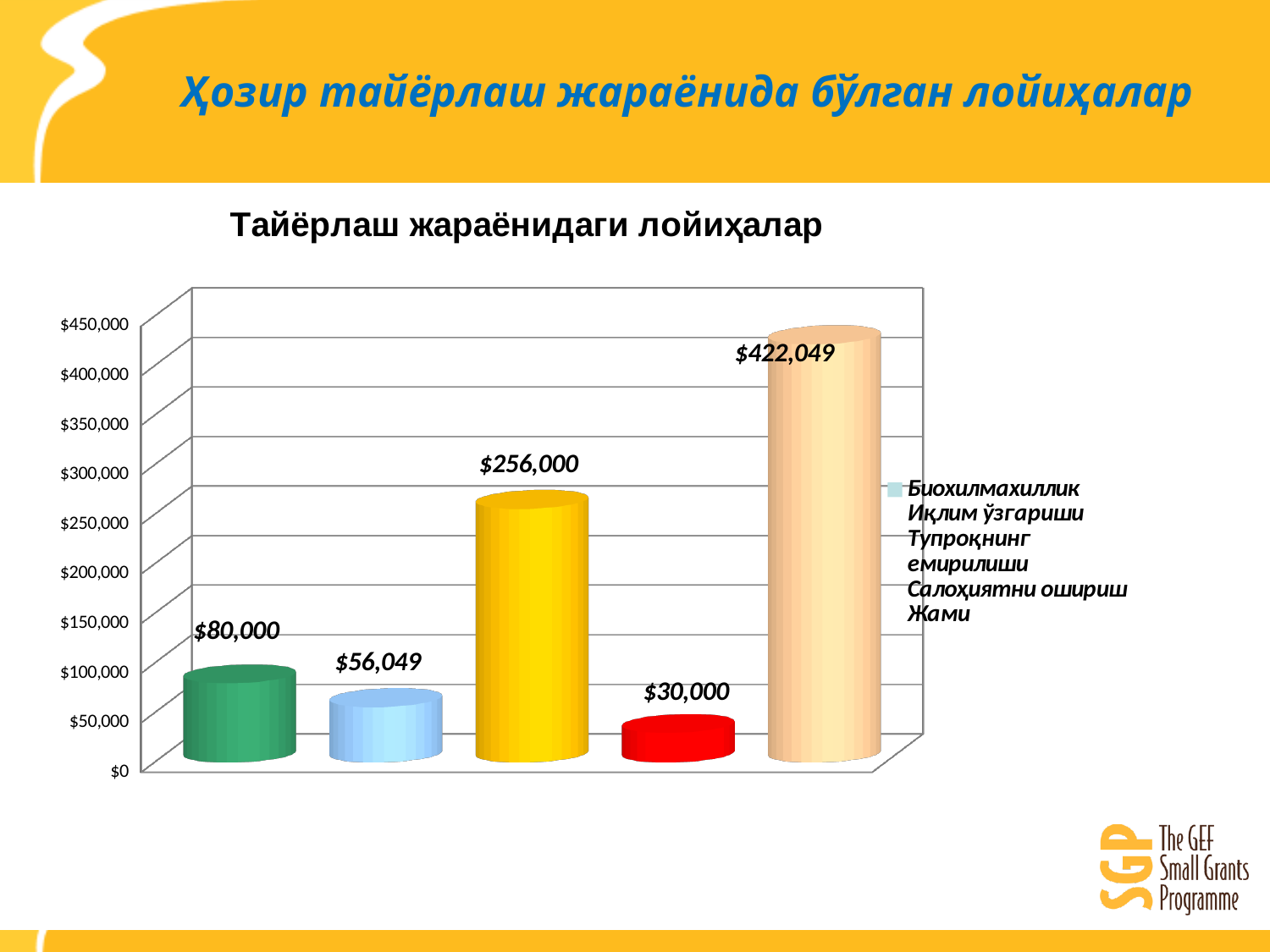
Is the value of the Иқлим ўзгариши bar greater or less than $100,000? less Which bar has the lowest value? Салоҳиятни ошириш ($30,000) How many bars are plotted in the chart? 5 How many entries does the chart legend list? 1 What is the difference between the Тупроқнинг емирилиши bar ($256,000) and the Биохилмахиллик bar ($80,000)? $176,000 Which is larger, the Биохилмахиллик bar or the Иқлим ўзгариши bar? Биохилмахиллик What is the value of the red bar, Салоҳиятни ошириш? $30,000 What is the title of the chart? Тайёрлаш жараёнидаги лойиҳалар What is the value of the first (green) bar, Биохилмахиллик? $80,000 What type of chart is shown on the slide? bar chart What is the value of the yellow bar, Тупроқнинг емирилиши? $256,000 What is the value shown on the tallest bar (Жами)? $422,049